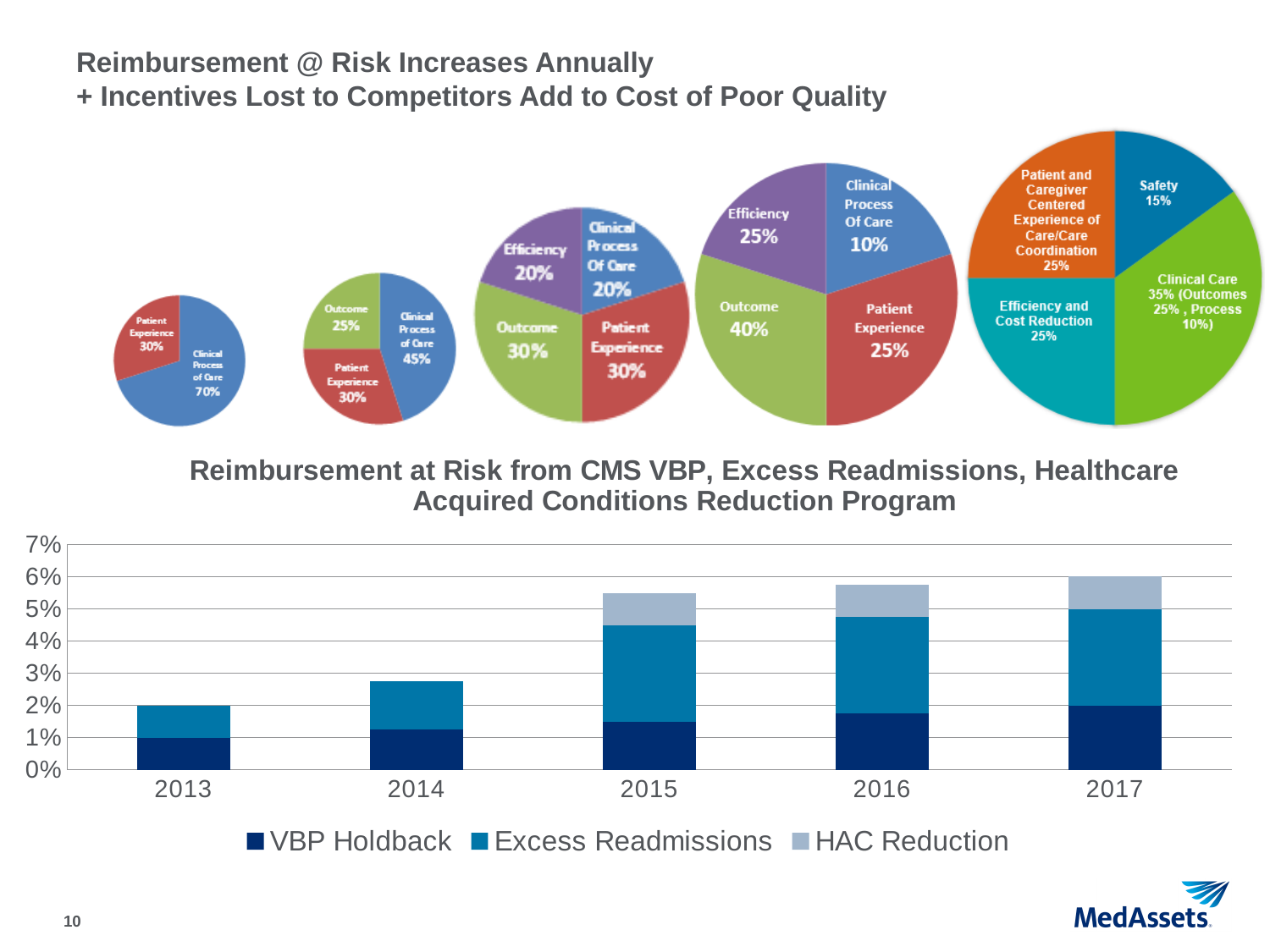
In the 'Reimbursement at Risk' bar chart, is the total for 2015 greater or less than 5%? greater What kind of chart is the 'Reimbursement at Risk from CMS VBP, Excess Readmissions, Healthcare Acquired Conditions Reduction Program' chart? Stacked bar chart How many series does the legend of the 'Reimbursement at Risk' bar chart list? 3 How many years are shown on the x axis of the 'Reimbursement at Risk' bar chart? 5 In the leftmost (smallest) pie chart at the top of the slide, what share is Clinical Process of Care? 70% What are the three legend entries of the 'Reimbursement at Risk' bar chart? VBP Holdback, Excess Readmissions, HAC Reduction In the 'Reimbursement at Risk' bar chart, which year has the highest total reimbursement at risk? 2017 In the rightmost (largest) pie chart at the top of the slide, what share is Safety? 15% In the 'Reimbursement at Risk' bar chart, which year has a larger total, 2014 or 2016? 2016 In the 'Reimbursement at Risk' bar chart, which year has the lowest total reimbursement at risk? 2013 In the 'Reimbursement at Risk' bar chart, do the total bar heights rise or fall from 2013 to 2017? Rise In the 'Reimbursement at Risk' bar chart, is the total for 2014 greater or less than 3%? less